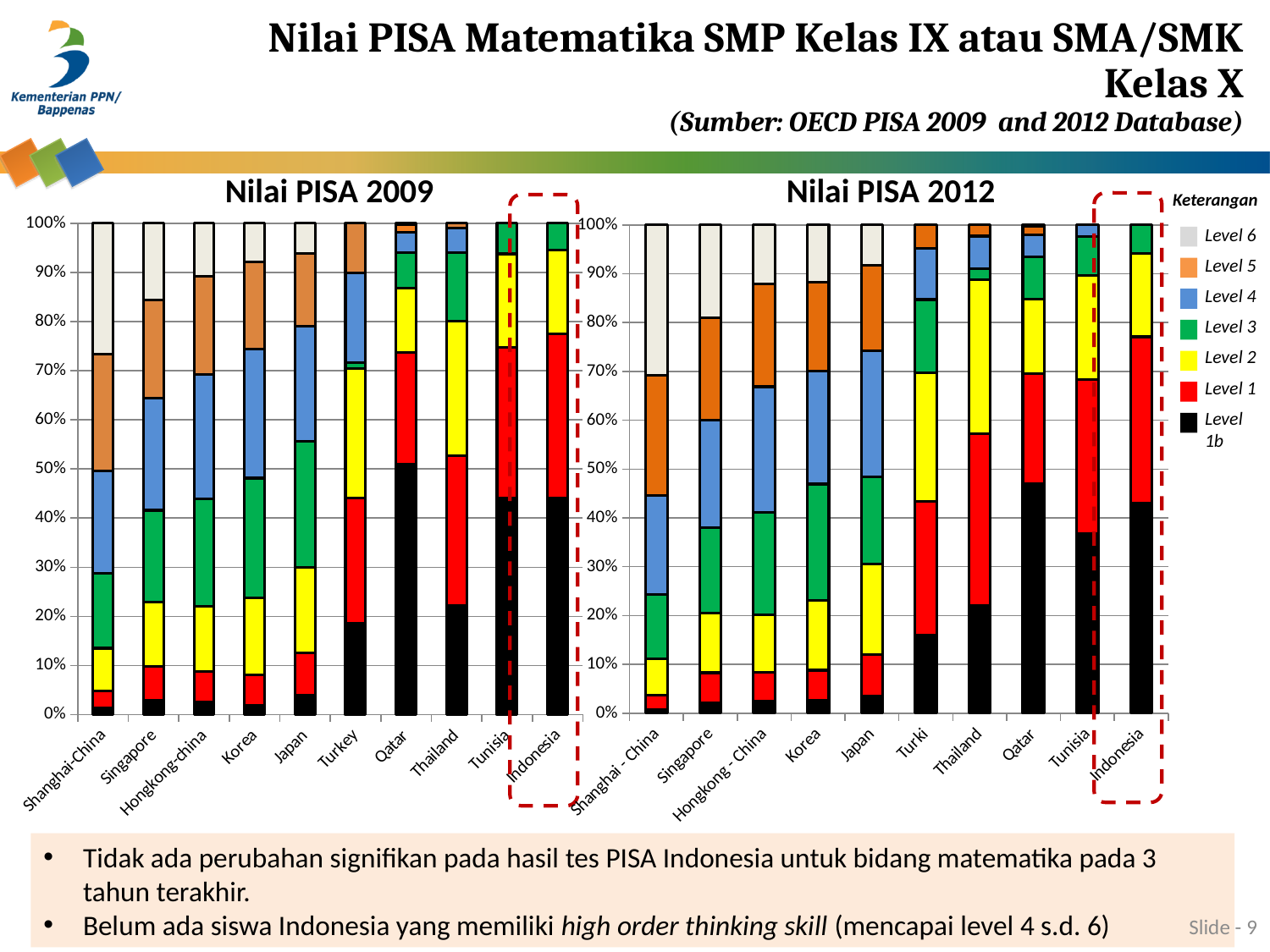
In the 'Nilai PISA 2009' chart, which has the larger Level 1b share, Indonesia or Thailand? Indonesia In the 'Nilai PISA 2009' chart, is the Level 1b share for Shanghai-China greater or less than 10%? less In the 'Nilai PISA 2012' chart, what is the total of the stacked bar for Indonesia? 100% In the 'Nilai PISA 2009' chart, is the Level 1b share for Indonesia greater or less than 40%? greater In the 'Nilai PISA 2012' chart, is the Level 1b share for Thailand greater or less than 30%? less How many levels does the 'Keterangan' legend list? 7 In the 'Nilai PISA 2009' chart, which country has the largest Level 1b share? Qatar What is the title of the left chart? Nilai PISA 2009 What kind of chart is the 'Nilai PISA 2009' chart? Stacked bar chart How many countries are shown on the x axis of the 'Nilai PISA 2012' chart? 10 Which colour represents Level 1b in the legend? Black